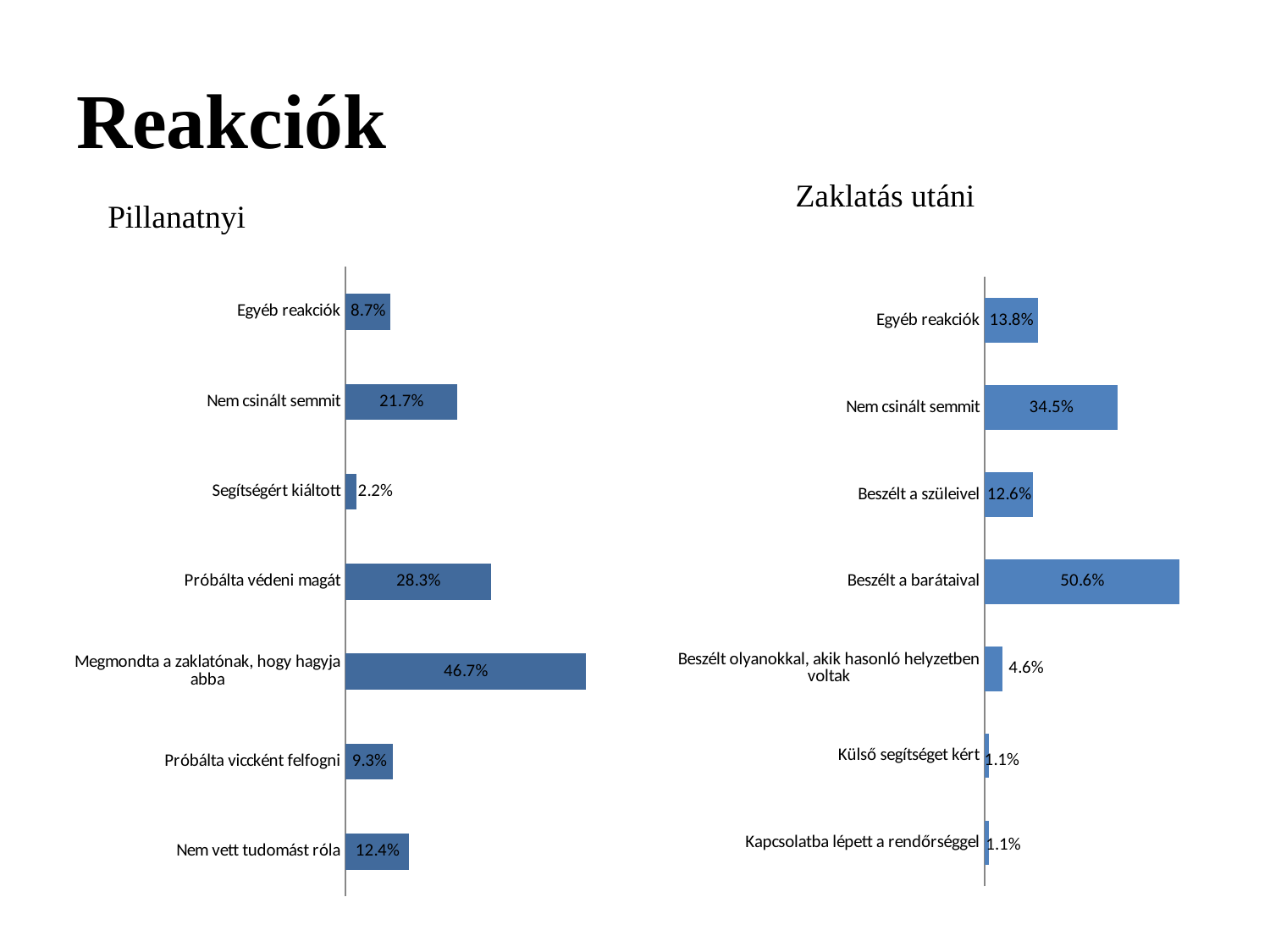
In the 'Pillanatnyi' chart, what is the difference between 'Próbálta védeni magát' and 'Nem csinált semmit'? 6.6% In the 'Pillanatnyi' chart, which category has the lowest value? Segítségért kiáltott How many categories are shown in the 'Zaklatás utáni' chart? 7 In the 'Zaklatás utáni' chart, what is the value for 'Külső segítséget kért'? 1.1% What kind of chart is the 'Zaklatás utáni' chart? Bar chart In the 'Zaklatás utáni' chart, what is the difference between 'Nem csinált semmit' and 'Egyéb reakciók'? 20.7% In the 'Zaklatás utáni' chart, which is larger: 'Beszélt a szüleivel' or 'Beszélt olyanokkal, akik hasonló helyzetben voltak'? Beszélt a szüleivel In the 'Zaklatás utáni' chart, which category has the highest value? Beszélt a barátaival How many categories are shown in the 'Pillanatnyi' chart? 7 In the 'Pillanatnyi' chart, which is larger: 'Nem vett tudomást róla' or 'Próbálta viccként felfogni'? Nem vett tudomást róla In the 'Zaklatás utáni' chart, what is the value for 'Beszélt a barátaival'? 50.6% In the 'Pillanatnyi' chart, what is the value for 'Megmondta a zaklatónak, hogy hagyja abba'? 46.7%